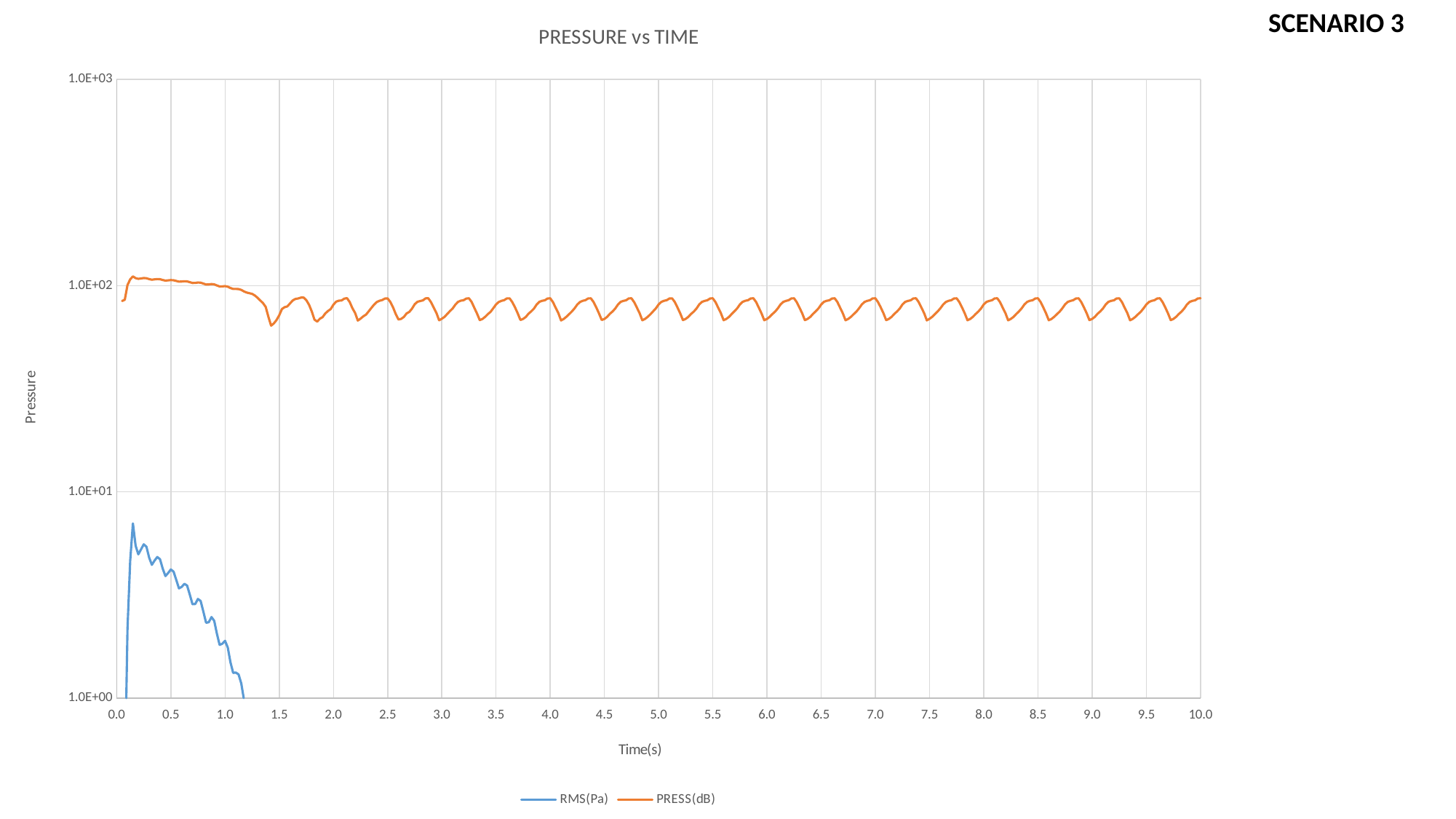
Is the value of the RMS(Pa) series at 0.5 s greater or less than 1.0E+00? greater What kind of chart is shown on the slide? line chart Which series is drawn in orange? PRESS(dB) How many series does the chart legend list? 2 Is the value of the PRESS(dB) series at 3.0 s greater or less than 1.0E+02? less Is the peak value of the RMS(Pa) series greater or less than 1.0E+01? less What is the title of the chart? PRESSURE vs TIME Which series has the higher values across the chart, RMS(Pa) or PRESS(dB)? PRESS(dB) Does the RMS(Pa) series rise or fall as time increases? fall What is the label of the x axis? Time(s)